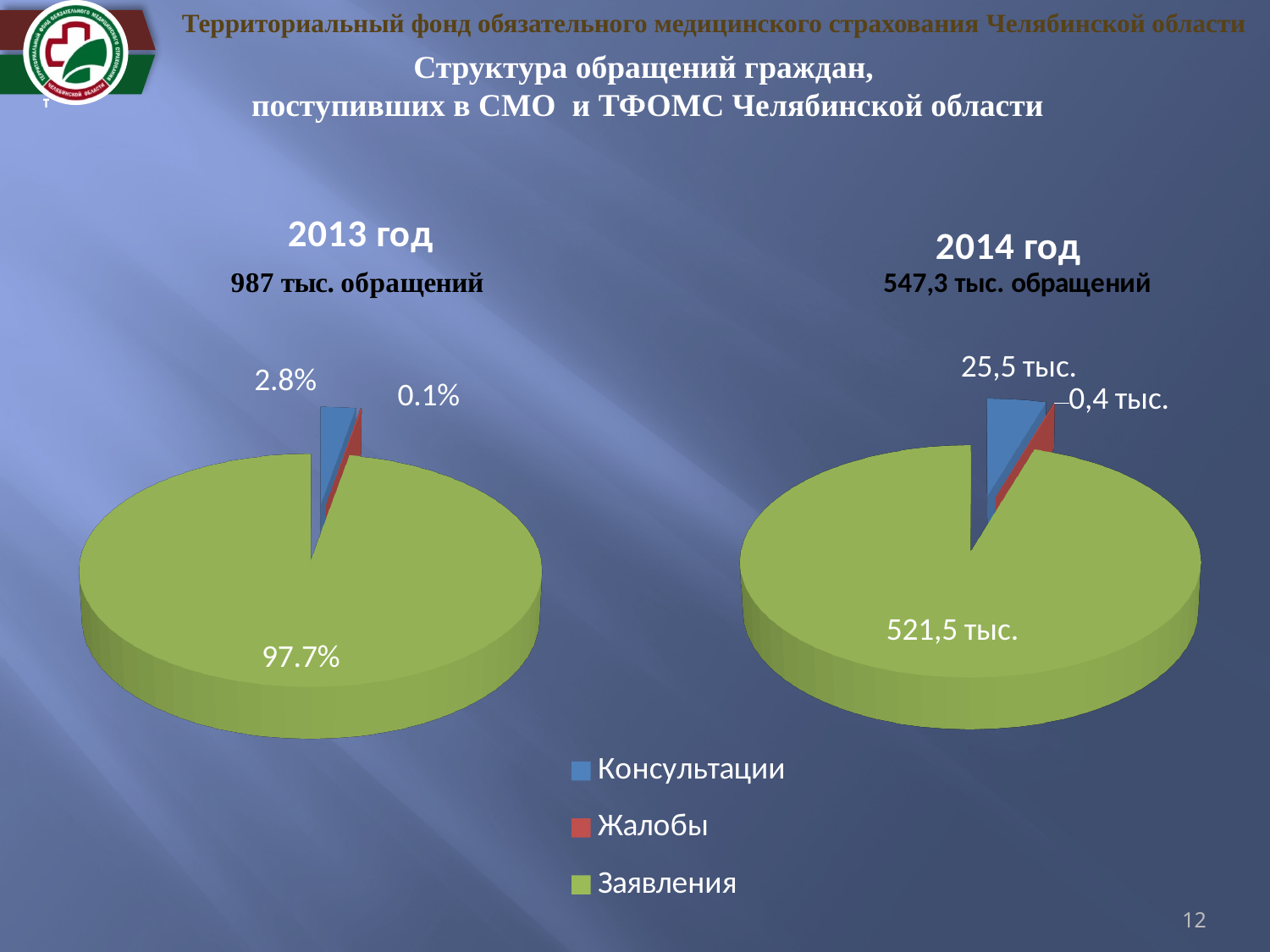
In the 2014 год pie chart, what is the value for Заявления? 521,5 тыс. In the 2013 год pie chart, what share do Жалобы account for? 0.1% In the 2013 год pie chart, what share do Консультации account for? 2.8% In the 2014 год pie chart, which is larger, Консультации or Жалобы? Консультации How many categories does the legend list for the pie charts? 3 In the 2014 год pie chart, which category has the largest slice? Заявления In the 2013 год pie chart, what share do Заявления account for? 97.7% In the 2014 год pie chart, what is the difference between Консультации and Жалобы? 25,1 тыс. In the 2014 год pie chart, what is the value for Жалобы? 0,4 тыс. What type of chart is used for the 2013 год data? Pie chart In the 2014 год pie chart, what is the value for Консультации? 25,5 тыс. In the 2013 год pie chart, which category has the smallest slice? Жалобы